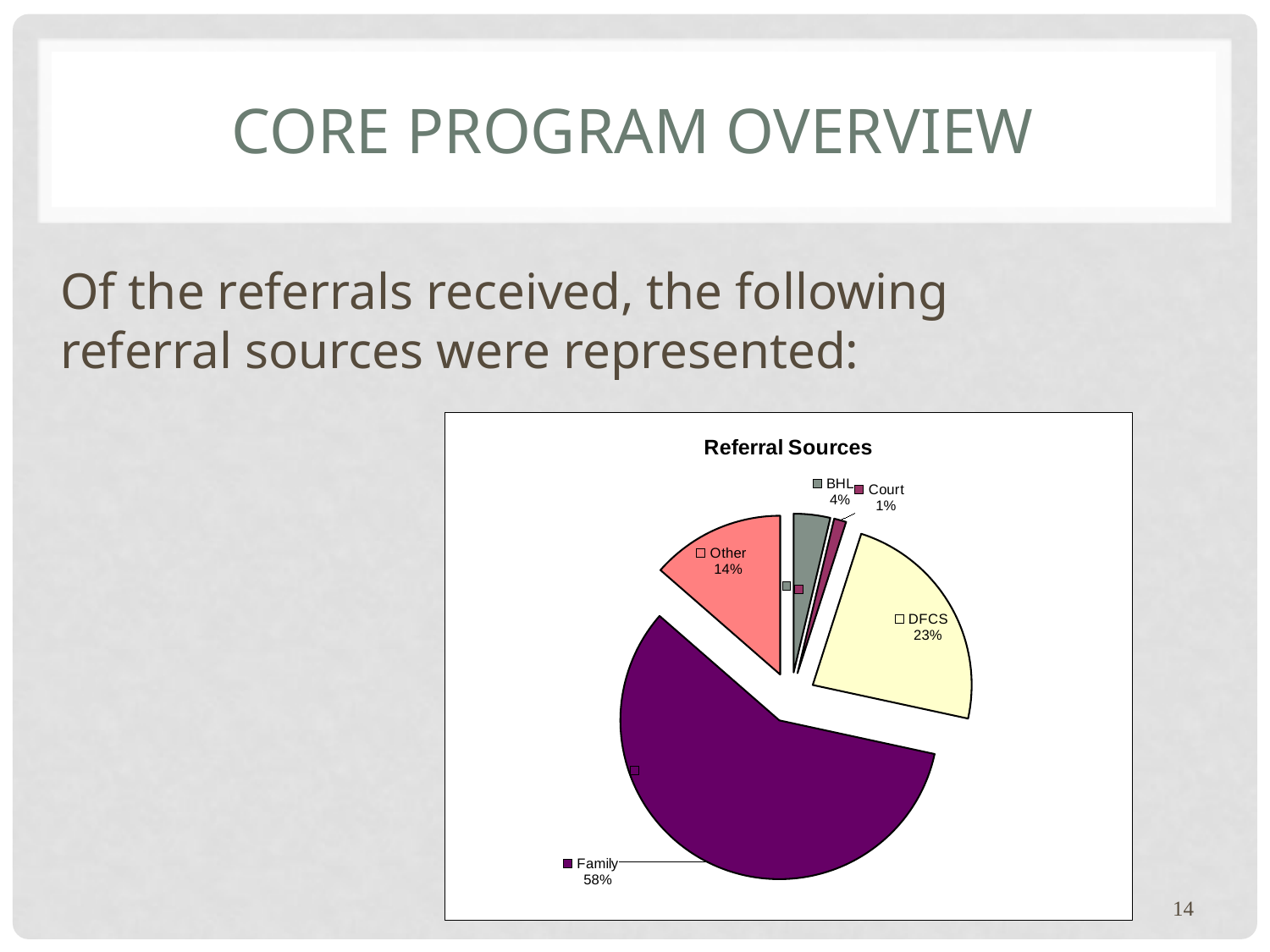
What is the difference in percentage points between the Family and DFCS shares? 35 Which referral source has the largest share? Family What share of referrals came from Other sources? 14% Which is larger, the share for Other or the share for BHL? Other What share of referrals came from BHL? 4% What share of referrals came from Family? 58% Which referral source has the smallest share? Court What is the title of the chart? Referral Sources What kind of chart is shown on the slide? Pie chart What share of referrals came from DFCS? 23% How many referral sources are shown in the pie chart? 5 What share of referrals came from Court? 1%